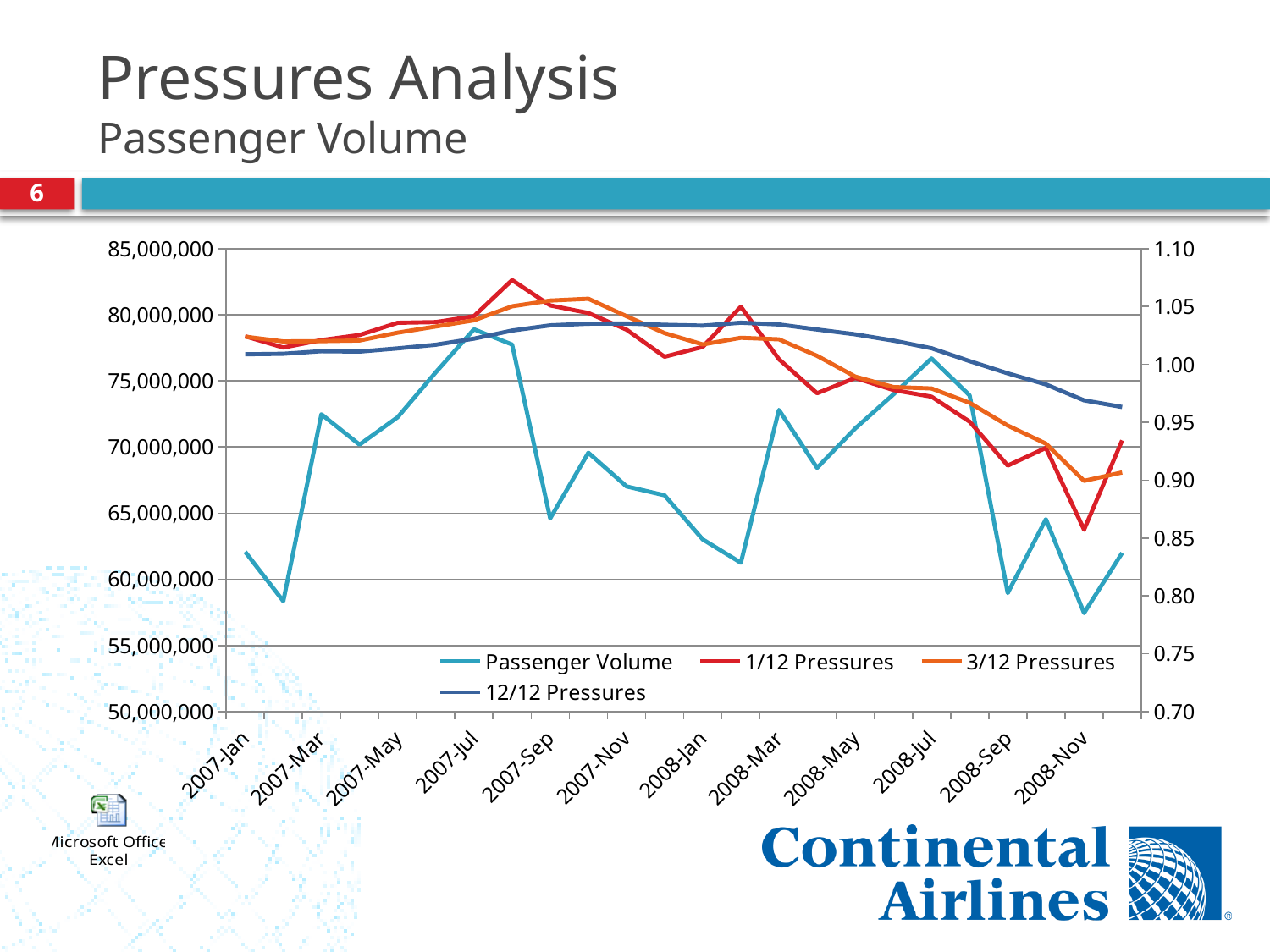
What kind of chart is shown on the slide? line chart Is the Passenger Volume value for 2007-Jul greater or less than 75,000,000? greater In which month does the Passenger Volume series reach its highest point? 2007-Jul Is the Passenger Volume value for 2007-Feb greater or less than 60,000,000? less Does the 12/12 Pressures series rise or fall over the course of 2008? fall Is the 1/12 Pressures value for 2007-Aug greater or less than 1.05? greater Which series are listed in the chart legend? Passenger Volume, 1/12 Pressures, 3/12 Pressures, 12/12 Pressures How many series does the legend list? 4 Which is larger, the Passenger Volume for 2007-Mar or for 2007-Apr? 2007-Mar What is the highest value shown on the left vertical axis? 85,000,000